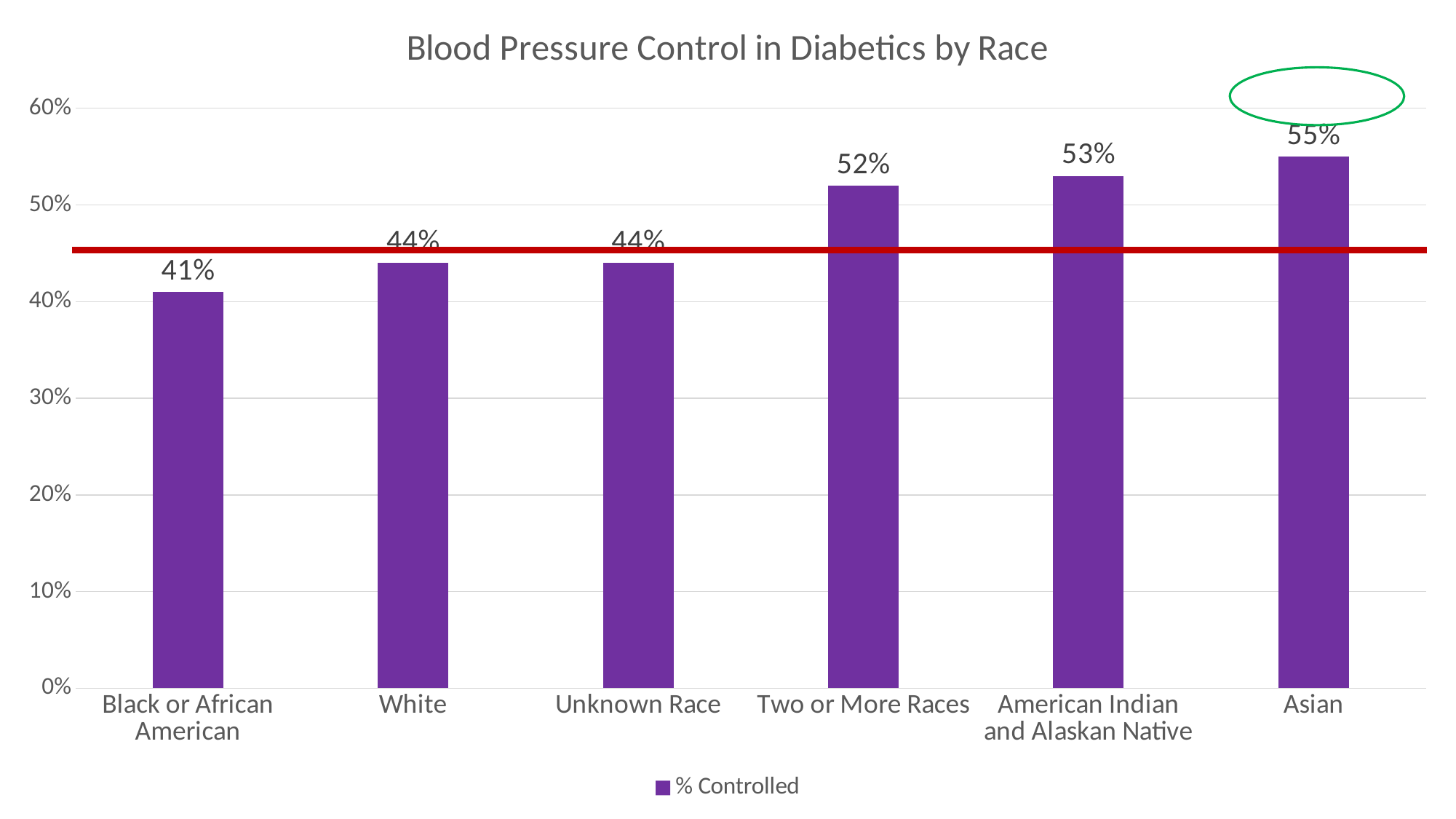
What is the difference in % Controlled between Two or More Races and White? 8% Which race category has the highest % Controlled? Asian What is the % Controlled value for Black or African American? 41% What is the title of the chart? Blood Pressure Control in Diabetics by Race What kind of chart is shown on the slide? Bar chart What is the % Controlled value for American Indian and Alaskan Native? 53% Is the value for Unknown Race greater or less than 50%? less What is the % Controlled value for Two or More Races? 52% Which race category has the lowest % Controlled? Black or African American Which has a higher % Controlled, White or Two or More Races? Two or More Races What is the difference in % Controlled between Asian and Black or African American? 14% How many race categories are shown on the chart? 6